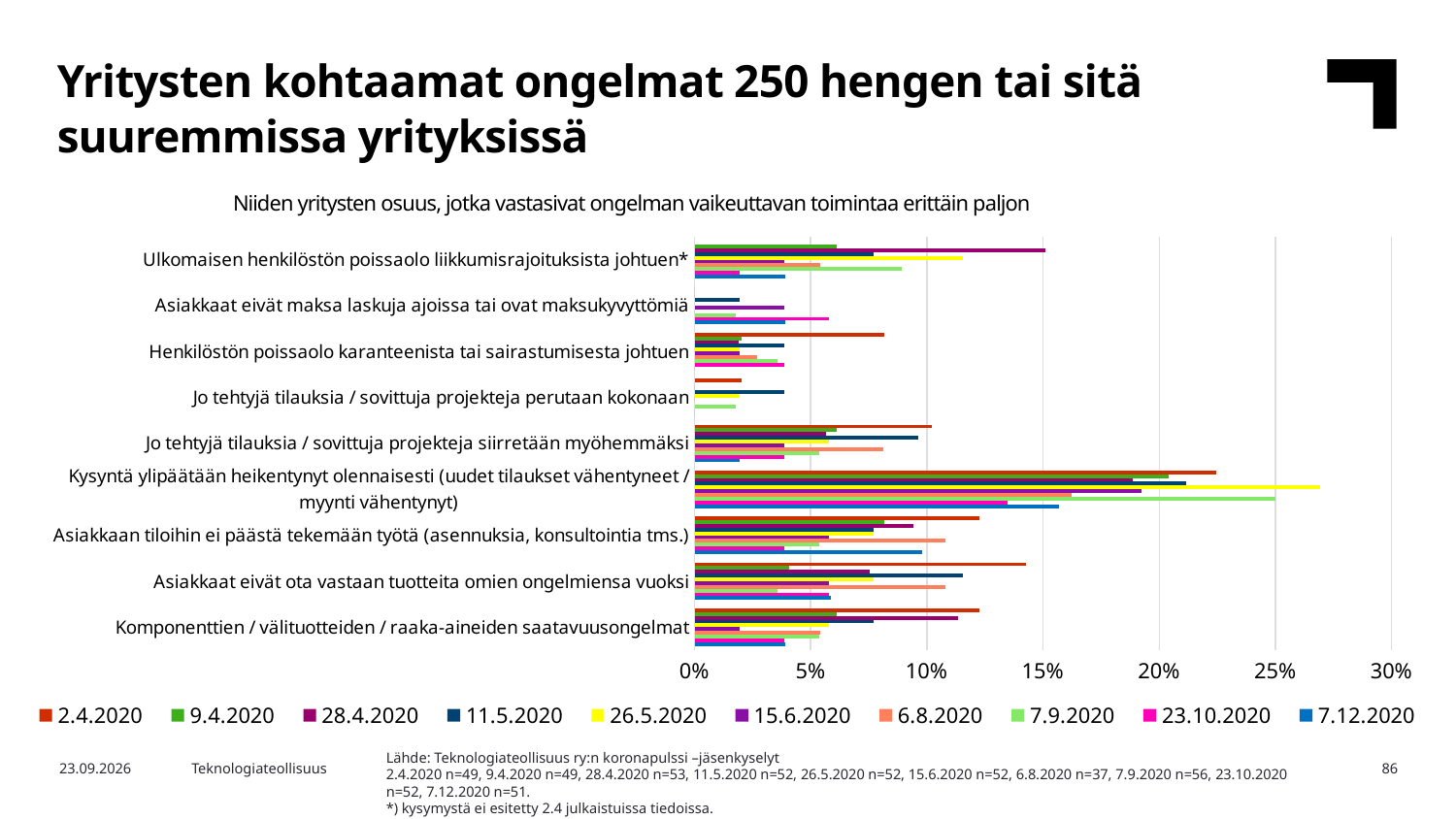
What is the highest value shown on the horizontal axis? 30% Is the 28.4.2020 value for 'Ulkomaisen henkilöstön poissaolo liikkumisrajoituksista johtuen*' greater or less than 10%? greater Is the 26.5.2020 value for 'Kysyntä ylipäätään heikentynyt olennaisesti' greater or less than 25%? greater Is the 2.4.2020 value for 'Kysyntä ylipäätään heikentynyt olennaisesti' greater or less than 20%? greater What is the subtitle shown above the chart? Niiden yritysten osuus, jotka vastasivat ongelman vaikeuttavan toimintaa erittäin paljon For the 2.4.2020 series, which is larger: 'Kysyntä ylipäätään heikentynyt olennaisesti' or 'Asiakkaat eivät ota vastaan tuotteita omien ongelmiensa vuoksi'? Kysyntä ylipäätään heikentynyt olennaisesti How many problem categories are listed on the chart? 9 Which category has the highest value on the chart? Kysyntä ylipäätään heikentynyt olennaisesti (uudet tilaukset vähentyneet / myynti vähentynyt) How many series (survey dates) does the legend list? 10 What kind of chart is shown on the slide? bar chart